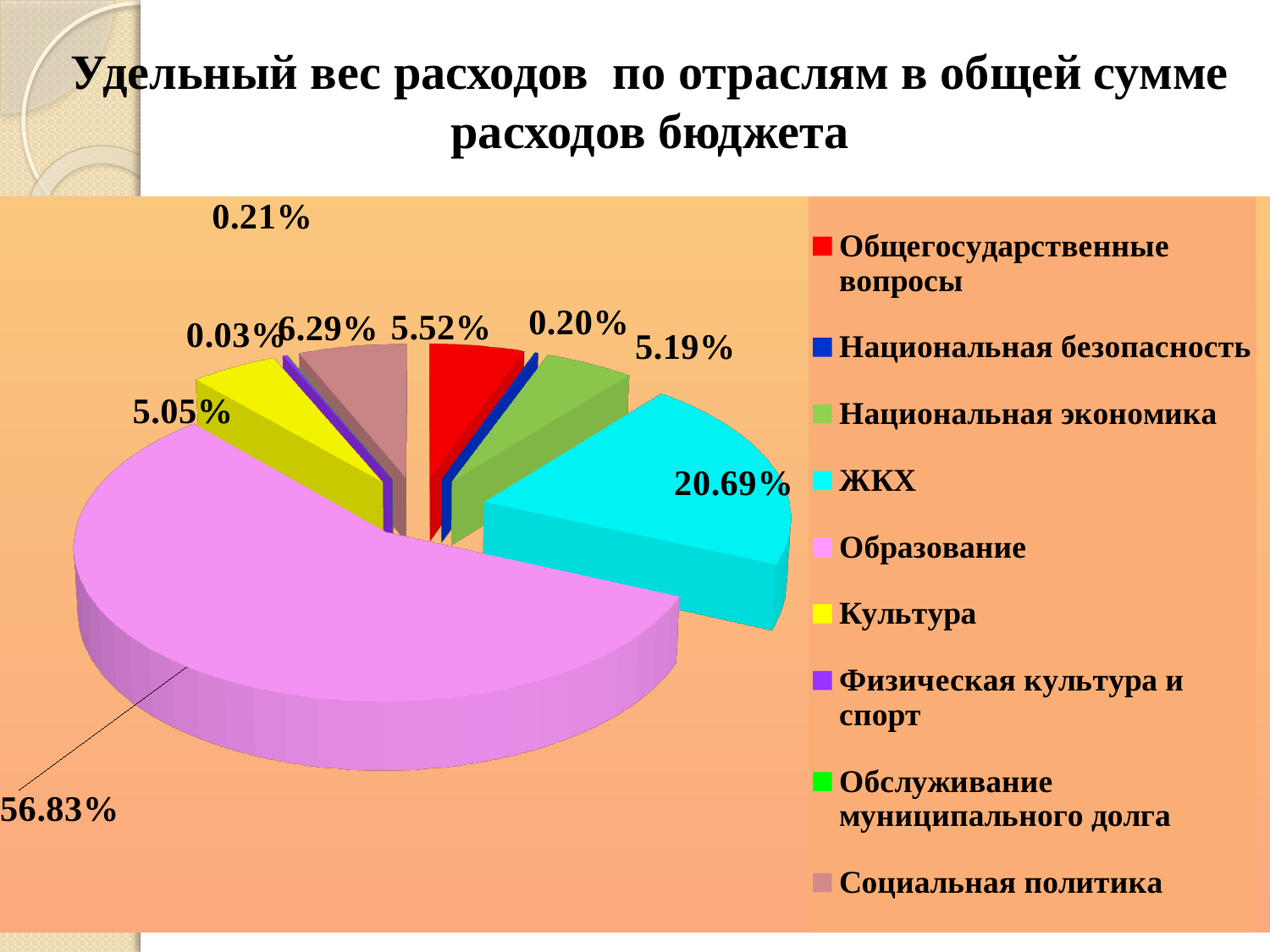
How many categories does the legend list? 9 What share is shown for Культура? 5.05% What share is shown for Общегосударственные вопросы? 5.52% Which category has the largest share of expenditure? Образование What share of budget expenditure goes to Образование? 56.83% What share is shown for Социальная политика? 6.29% What share is shown for Национальная экономика? 5.19% What colour is the Образование slice? pink By how many percentage points does the share of Образование exceed the share of ЖКХ? 36.14% What kind of chart is shown on the slide? pie chart What share of budget expenditure goes to ЖКХ? 20.69% Which has the larger share, ЖКХ or Социальная политика? ЖКХ